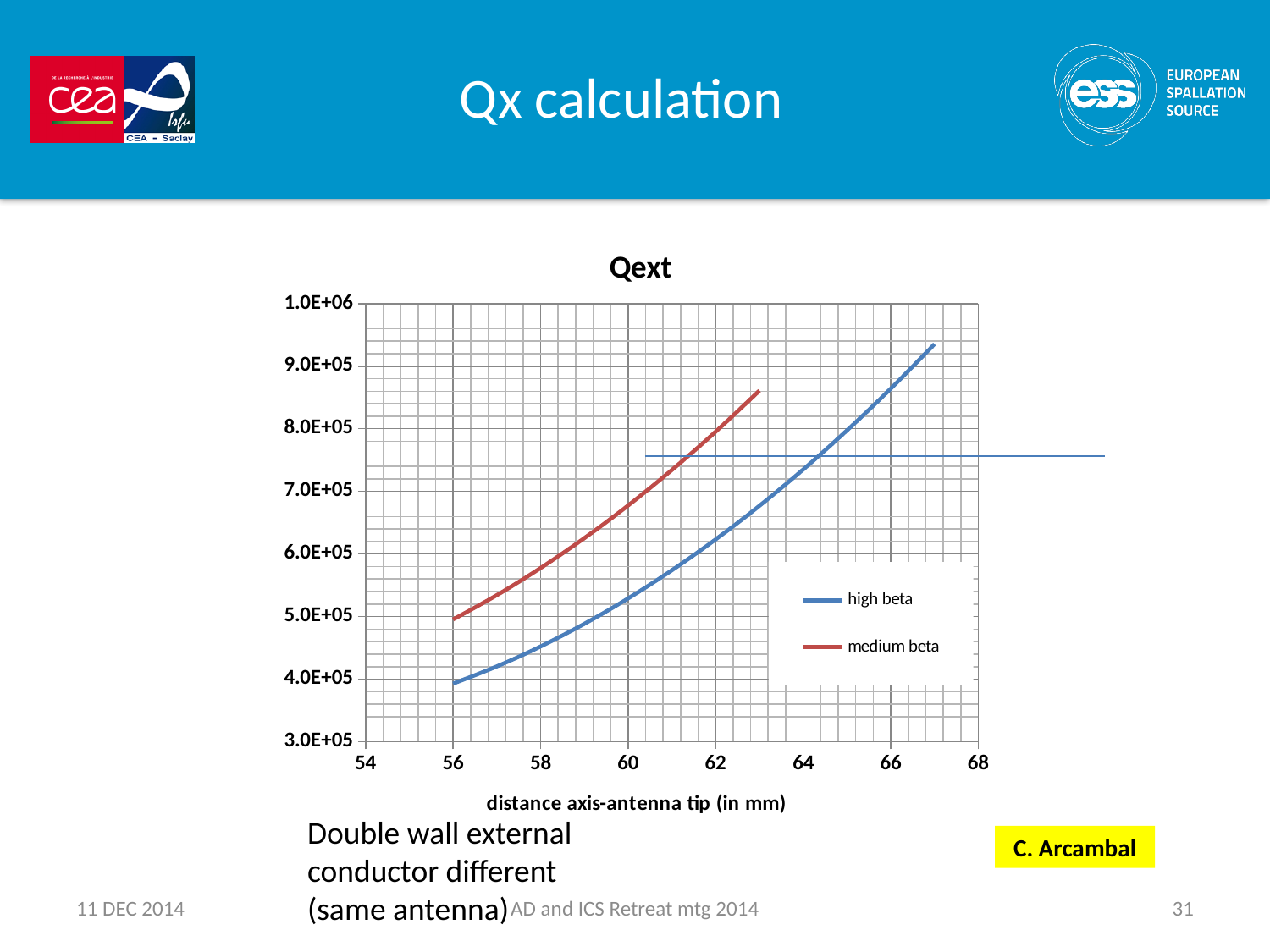
Is the Qext value for medium beta at 63 mm greater or less than 8.0E+05? greater Do the values of the high beta series rise or fall as the distance increases along the x axis? rise Is the Qext value for high beta at 58 mm greater or less than 5.0E+05? less Is the Qext value for high beta at 67 mm greater or less than 9.0E+05? greater What is the x-axis title of the Qext chart? distance axis-antenna tip (in mm) How many series does the legend of the Qext chart list? 2 What is the title of the chart? Qext What kind of chart is shown on the slide? line chart Do the values of the medium beta series rise or fall as the distance increases along the x axis? rise At a distance of 60 mm, which series has the larger Qext value, high beta or medium beta? medium beta